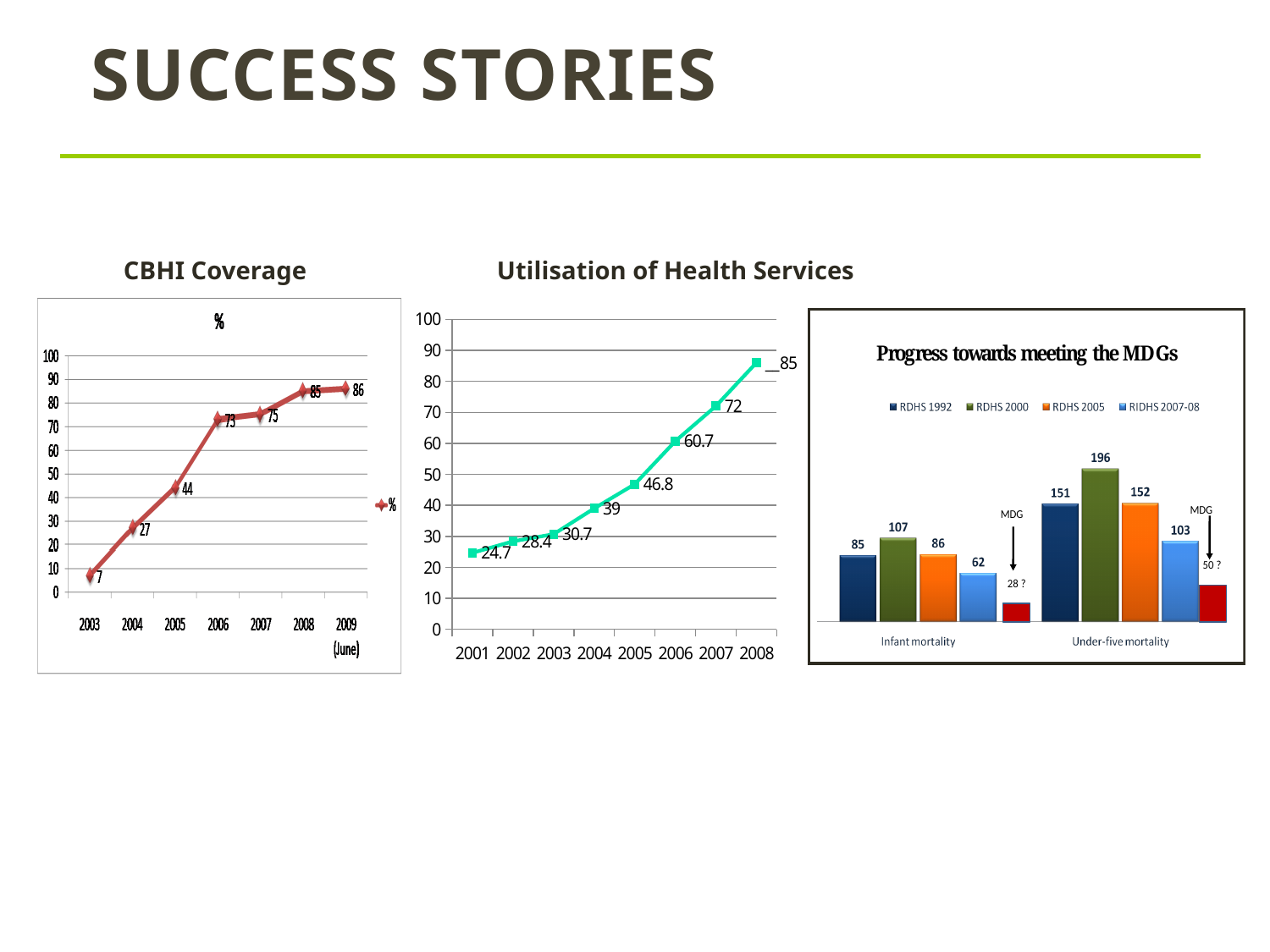
What kind of chart is the Utilisation of Health Services chart? line chart In the Utilisation of Health Services chart, which year has the lowest value? 2001 In the CBHI Coverage chart, what is the value for 2009 (June)? 86 In the CBHI Coverage chart, what is the value for 2005? 44 In the Utilisation of Health Services chart, what is the value for 2006? 60.7 In the CBHI Coverage chart, what is the difference between the values for 2006 and 2004? 46 In the Progress towards meeting the MDGs chart, what is the RDHS 2000 value for Under-five mortality? 196 In the Progress towards meeting the MDGs chart, what is the difference between the RDHS 2005 and RIDHS 2007-08 values for Under-five mortality? 49 In the CBHI Coverage chart, do the values rise or fall from 2003 to 2009? rise In the Progress towards meeting the MDGs chart, how many series does the legend list? 4 In the Utilisation of Health Services chart, how many years are plotted? 8 In the Progress towards meeting the MDGs chart, which is larger for Infant mortality: RDHS 1992 or RIDHS 2007-08? RDHS 1992